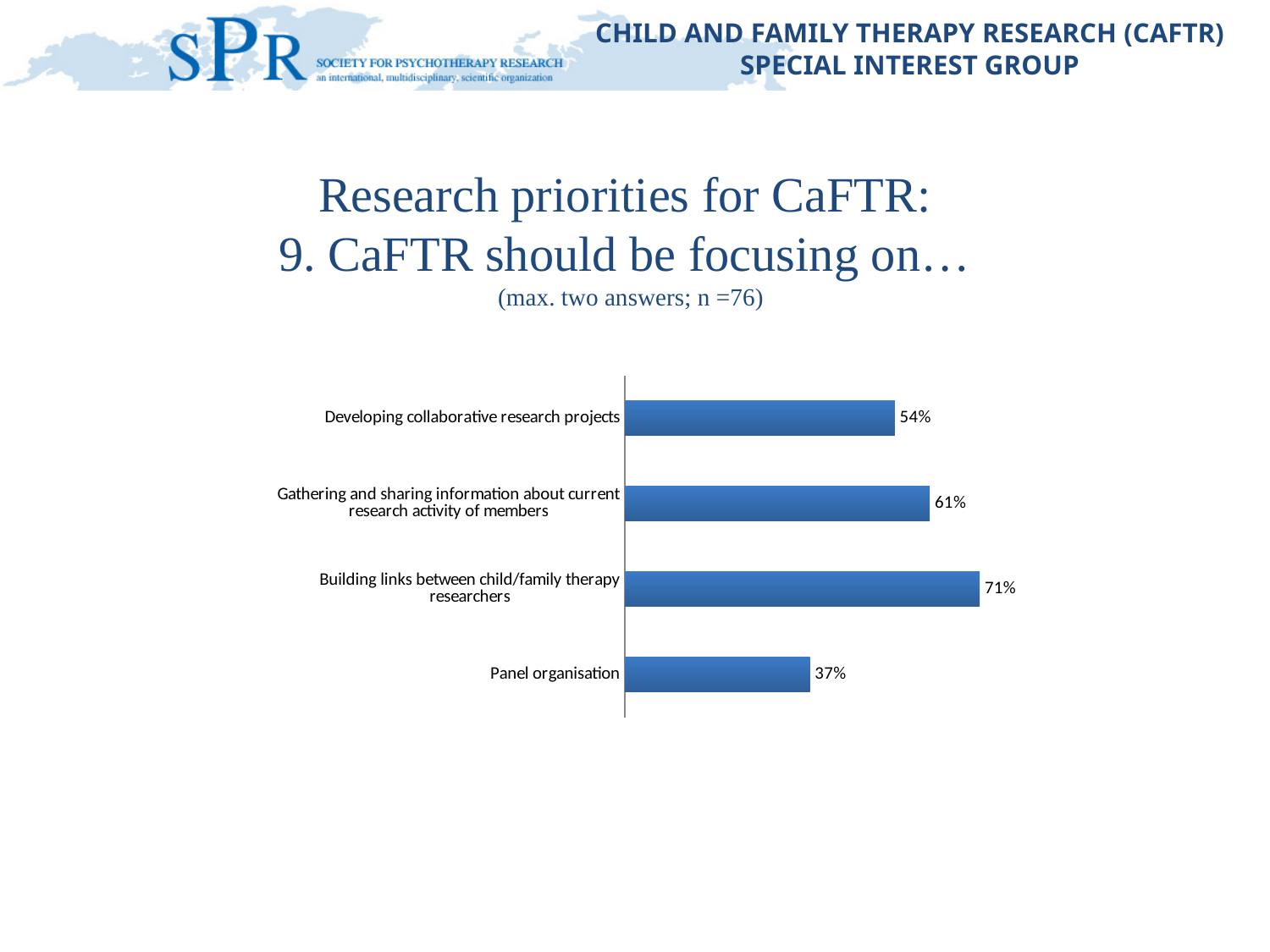
Which category has the highest value? Building links between child/family therapy researchers According to the subtitle, how many respondents (n) answered this question? 76 What kind of chart is shown on the slide? Bar chart Which is larger: the value for 'Developing collaborative research projects' or for 'Gathering and sharing information about current research activity of members'? Gathering and sharing information about current research activity of members What is the difference between the values for 'Building links between child/family therapy researchers' and 'Panel organisation'? 34% What is the difference between the values for 'Gathering and sharing information about current research activity of members' and 'Developing collaborative research projects'? 7% What percentage of respondents chose 'Developing collaborative research projects'? 54% Which category has the lowest value? Panel organisation What is the value for 'Gathering and sharing information about current research activity of members'? 61% What is the value for 'Panel organisation'? 37% What is the value for 'Building links between child/family therapy researchers'? 71% How many categories are shown in the chart? 4